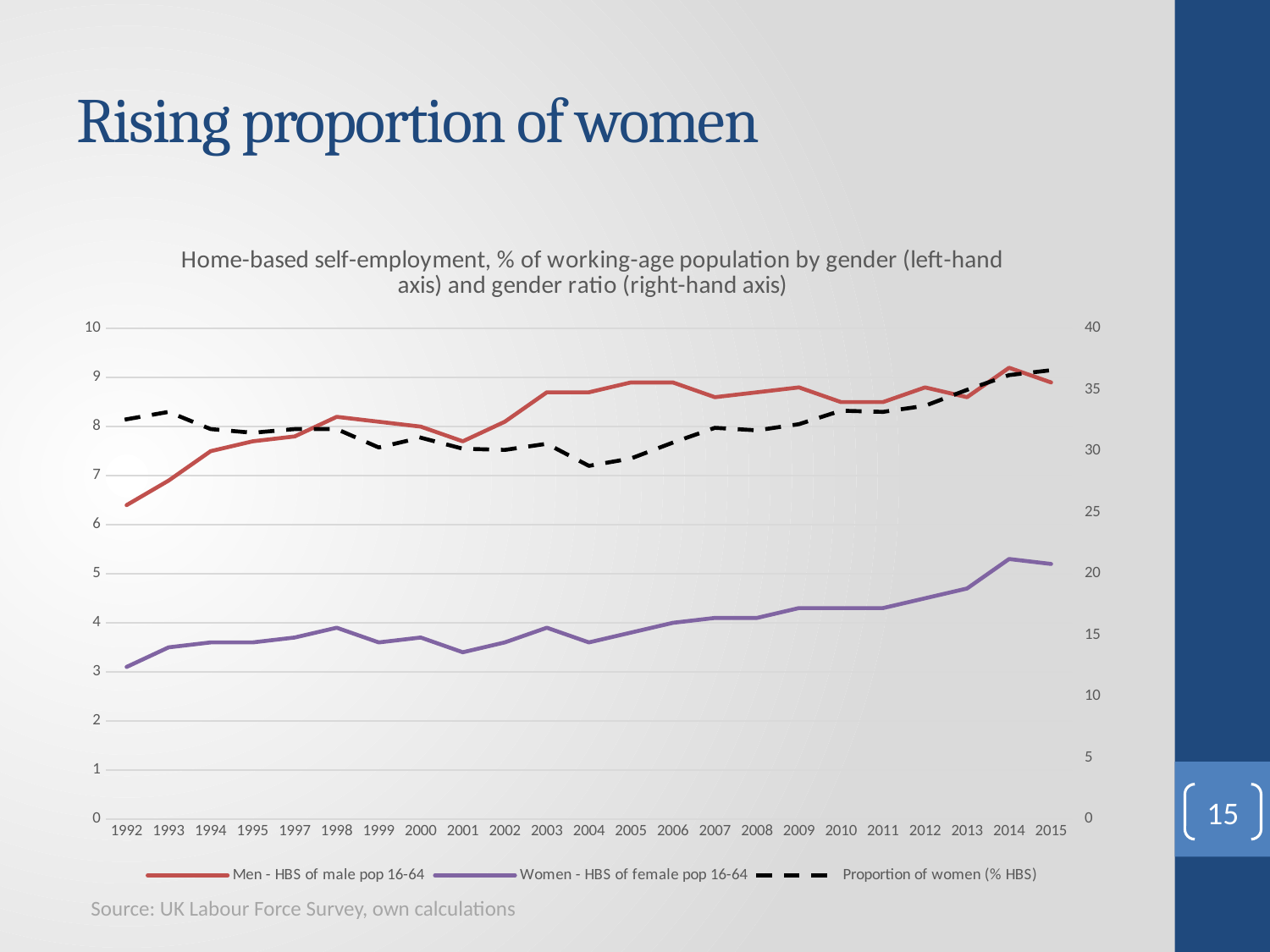
In which year is the Proportion of women (% HBS) series at its lowest? 2004 Is the value for Women - HBS of female pop 16-64 in 2001 greater or less than 4? less Is the value for Men - HBS of male pop 16-64 in 2014 greater or less than 9? greater Is the value for Men - HBS of male pop 16-64 in 1992 greater or less than 7? less In which year is the Men - HBS of male pop 16-64 series at its lowest? 1992 Which series is higher in 2015, Men - HBS of male pop 16-64 or Women - HBS of female pop 16-64? Men - HBS of male pop 16-64 How many series does the legend list? 3 How many years are plotted along the x axis? 23 What kind of chart is shown on the slide? line chart In which year is the Women - HBS of female pop 16-64 series at its highest? 2014